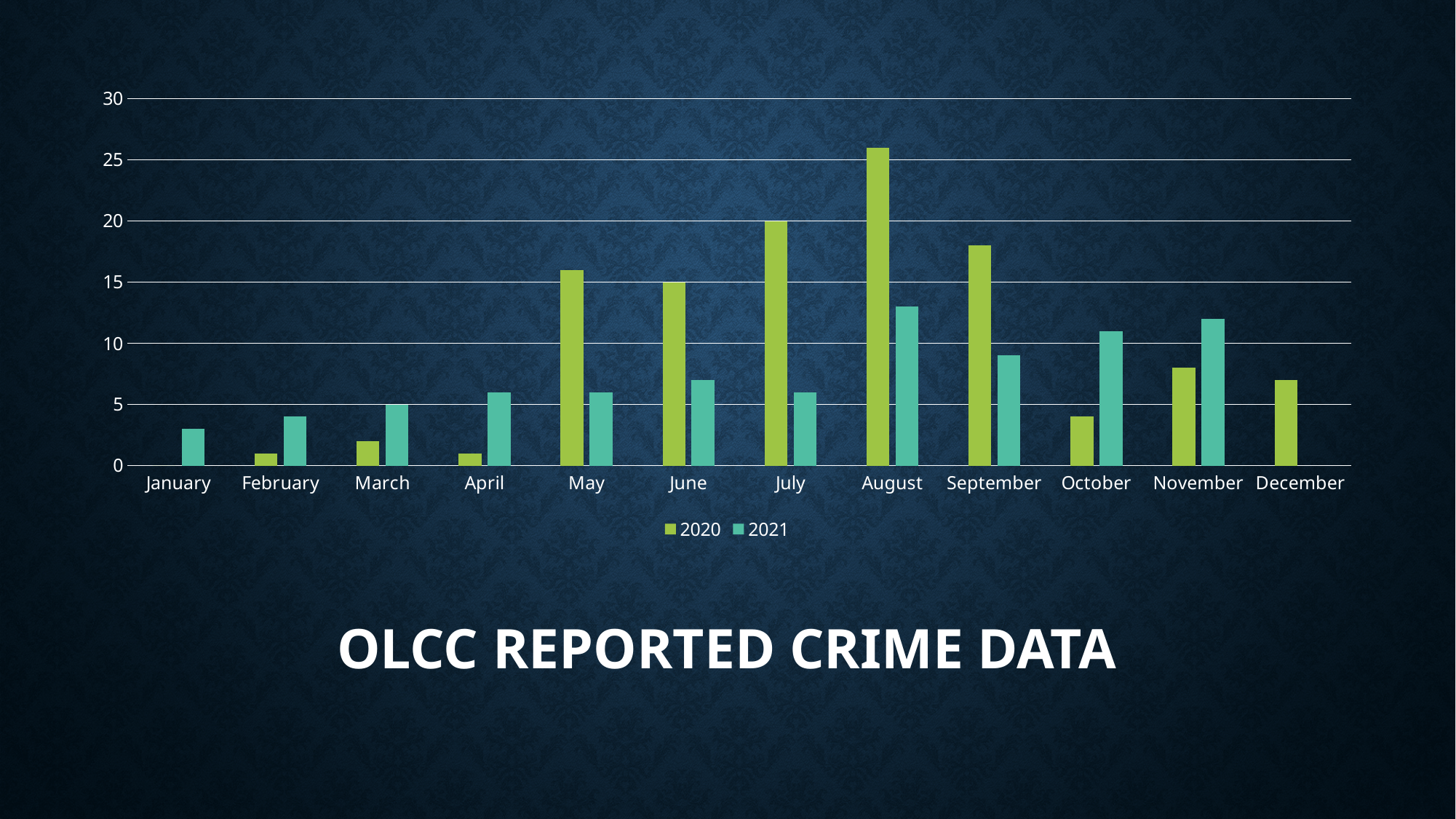
What is the value for March in the 2021 series? 5 What is the value for June in the 2020 series? 15 Is the value for August in the 2020 series greater or less than 25? greater Which is larger for May: the 2020 value or the 2021 value? 2020 Is the value for November in the 2021 series greater or less than 10? greater What is the value for July in the 2020 series? 20 Which is larger for October: the 2020 value or the 2021 value? 2021 Which month has the highest value in the 2020 series? August What kind of chart is shown on the slide? Bar chart How many months are shown on the x axis? 12 Is the value for January in the 2021 series greater or less than 5? less How many series does the legend list? 2